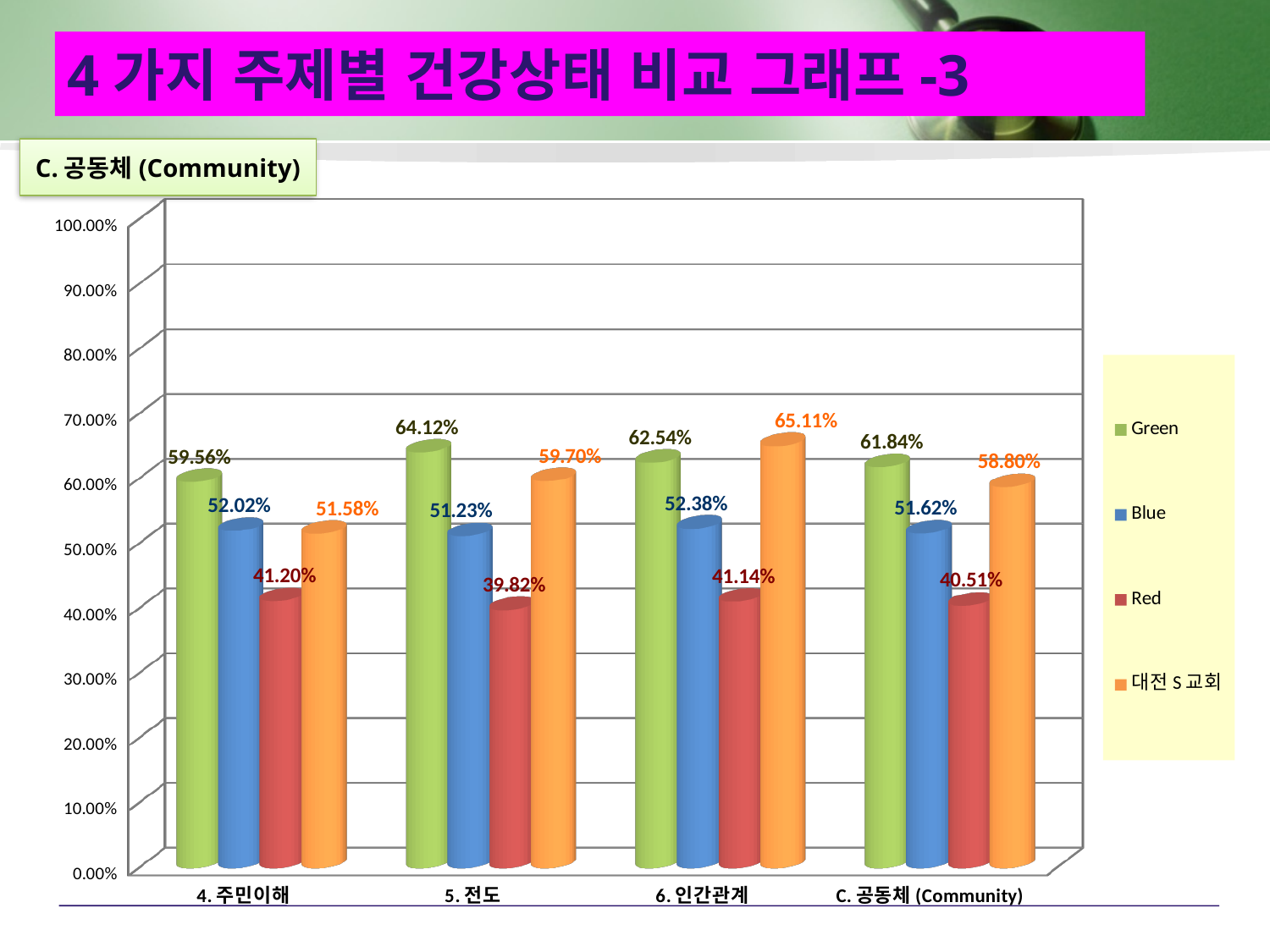
What is the value of the Red series for C. 공동체 (Community)? 40.51% What kind of chart is shown on the slide? Bar chart Which category has the lowest Red value? 5. 전도 Which category has the highest Green value? 5. 전도 How many categories are shown on the x axis? 4 For 6. 인간관계, which is larger: the Green value or the 대전 S 교회 value? 대전 S 교회 What is the value of the Blue series for 4. 주민이해? 52.02% What is the difference between the Green and Red values for 4. 주민이해? 18.36% What is the last entry in the chart legend? 대전 S 교회 What is the value of the Green series for 5. 전도? 64.12% What is the value of the 대전 S 교회 series for 6. 인간관계? 65.11% How many series does the legend list? 4